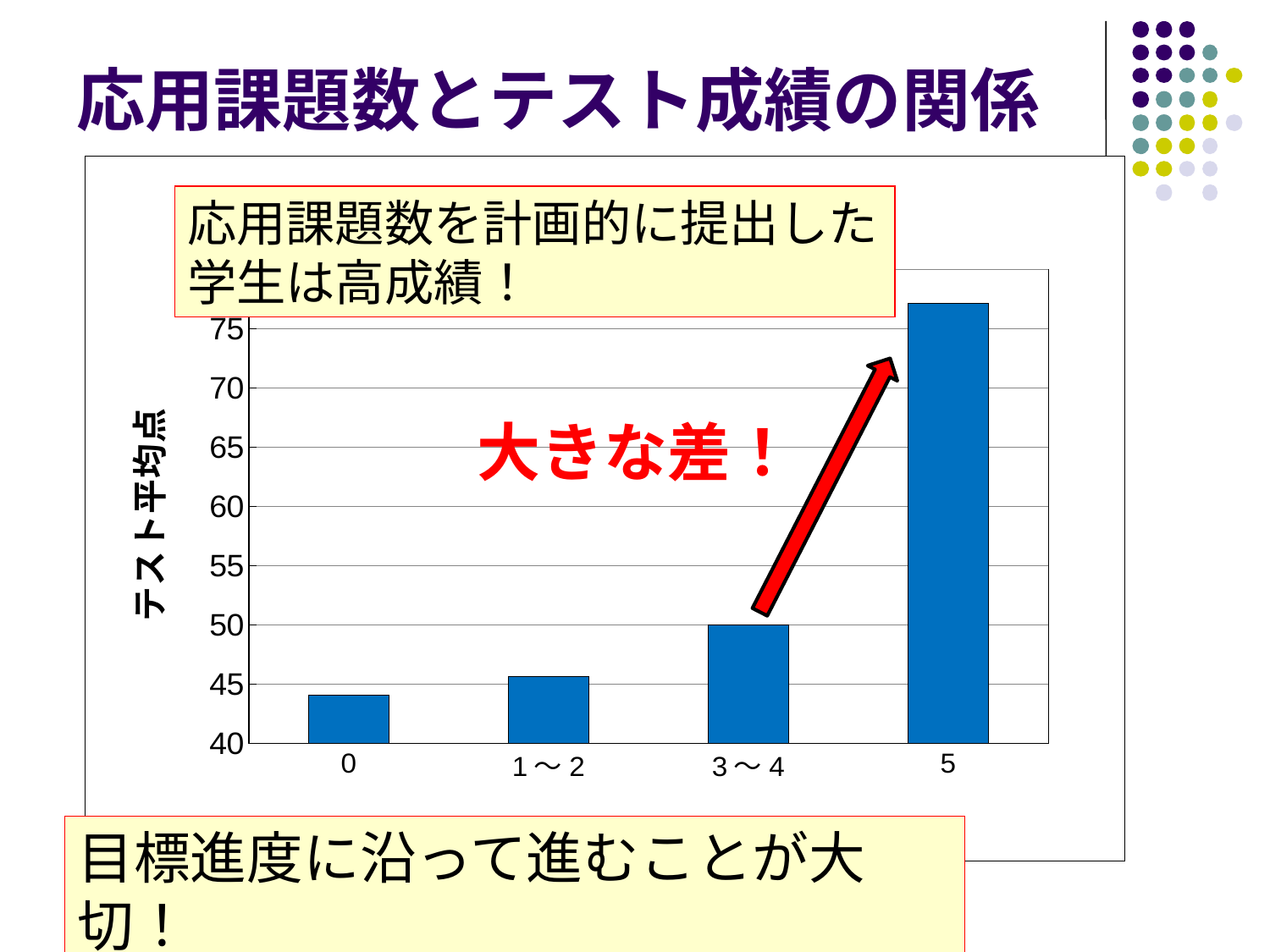
How many categories are shown on the x axis of the chart? 4 Is the value for category 1～2 greater or less than 50? less Which category has the lowest テスト平均点? 0 Do the values rise or fall as you move from category 0 to category 5 along the x axis? rise What is the title of the slide containing the chart? 応用課題数とテスト成績の関係 What is the label on the vertical axis of the chart? テスト平均点 Which has a higher テスト平均点, category 0 or category 3～4? 3～4 Which category has the highest テスト平均点? 5 Is the value for category 5 greater or less than 75? greater Is the value for category 0 greater or less than 45? less What kind of chart is shown on the slide? bar chart Which has a higher テスト平均点, category 3～4 or category 5? 5